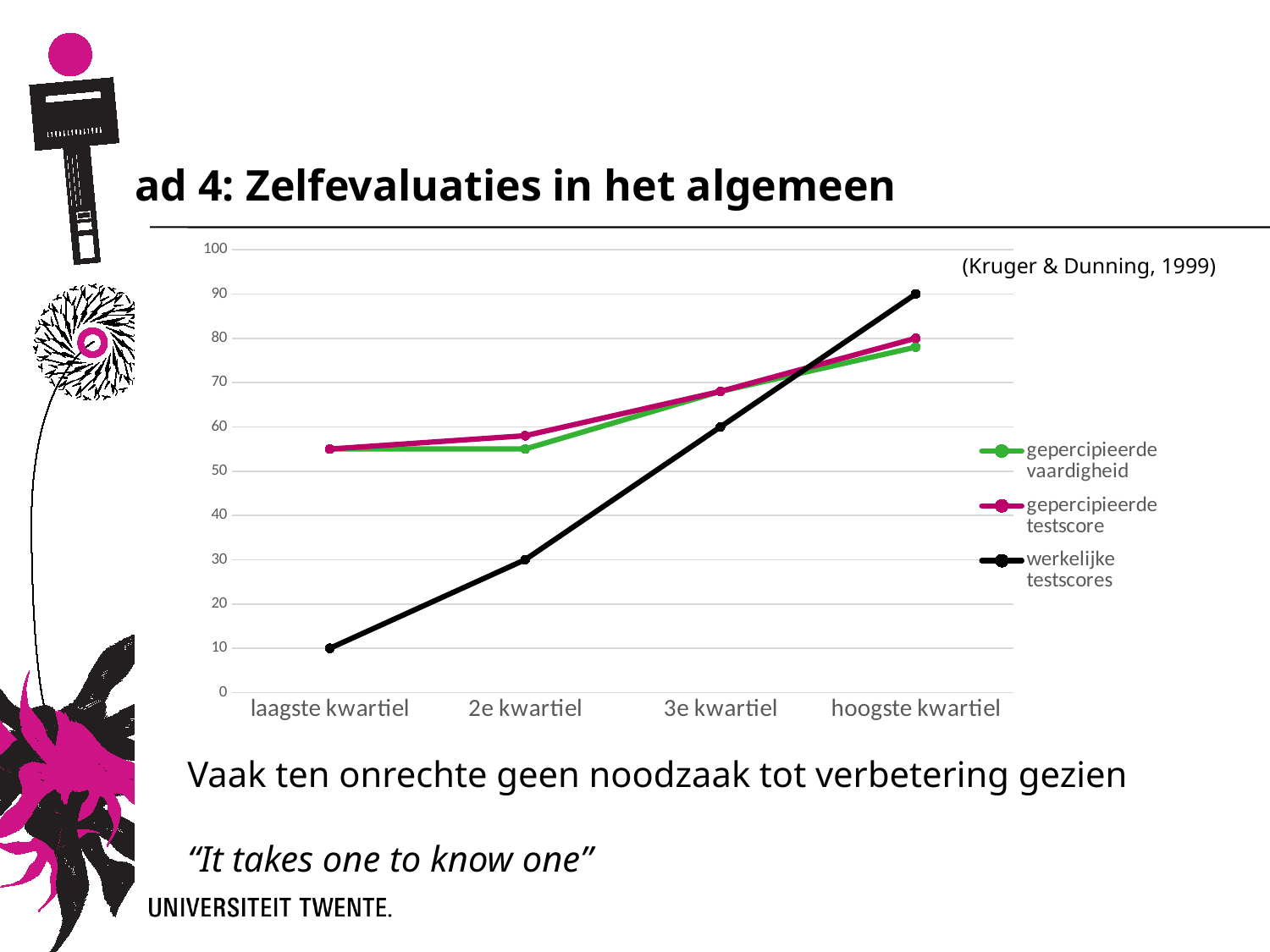
Is the value of gepercipieerde vaardigheid for laagste kwartiel greater or less than 50? greater Do the werkelijke testscores rise or fall from laagste kwartiel to hoogste kwartiel? rise Which category has the lowest value for werkelijke testscores? laagste kwartiel What kind of chart is shown on the slide? line chart Is the value of werkelijke testscores for 3e kwartiel greater or less than 50? greater How many categories are shown on the x axis? 4 What is the value of werkelijke testscores for hoogste kwartiel? 90 What is the value of werkelijke testscores for laagste kwartiel? 10 Which category has the highest value for gepercipieerde testscore? hoogste kwartiel What is the value of werkelijke testscores for 2e kwartiel? 30 How many series does the legend list? 3 For laagste kwartiel, which is larger: gepercipieerde testscore or werkelijke testscores? gepercipieerde testscore